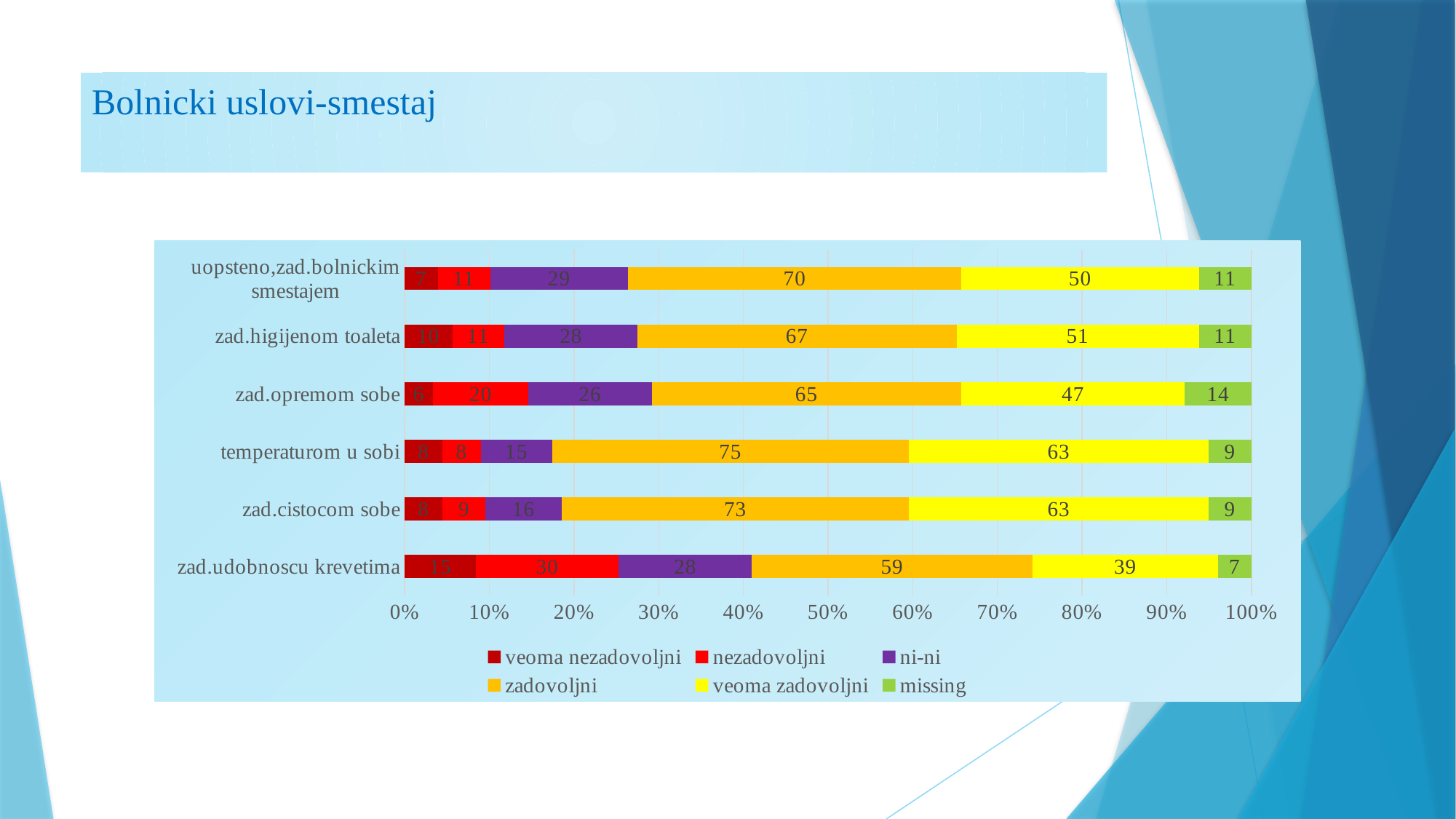
What is the title of the slide? Bolnicki uslovi-smestaj How many categories are shown on the chart? 6 What is the 'nezadovoljni' value for 'zad.udobnoscu krevetima'? 30 What kind of chart is shown on the slide? stacked bar chart What is the 'veoma zadovoljni' value for 'zad.higijenom toaleta'? 51 How many series does the legend list? 6 Which category has the highest 'zadovoljni' value? temperaturom u sobi What is the difference between the 'zadovoljni' values for 'zad.cistocom sobe' and 'zad.udobnoscu krevetima'? 14 Which category has the lowest 'veoma zadovoljni' value? zad.udobnoscu krevetima What is the 'zadovoljni' value for 'temperaturom u sobi'? 75 Which is larger: the 'ni-ni' value for 'uopsteno,zad.bolnickim smestajem' or for 'zad.cistocom sobe'? uopsteno,zad.bolnickim smestajem What is the 'missing' value for 'zad.opremom sobe'? 14